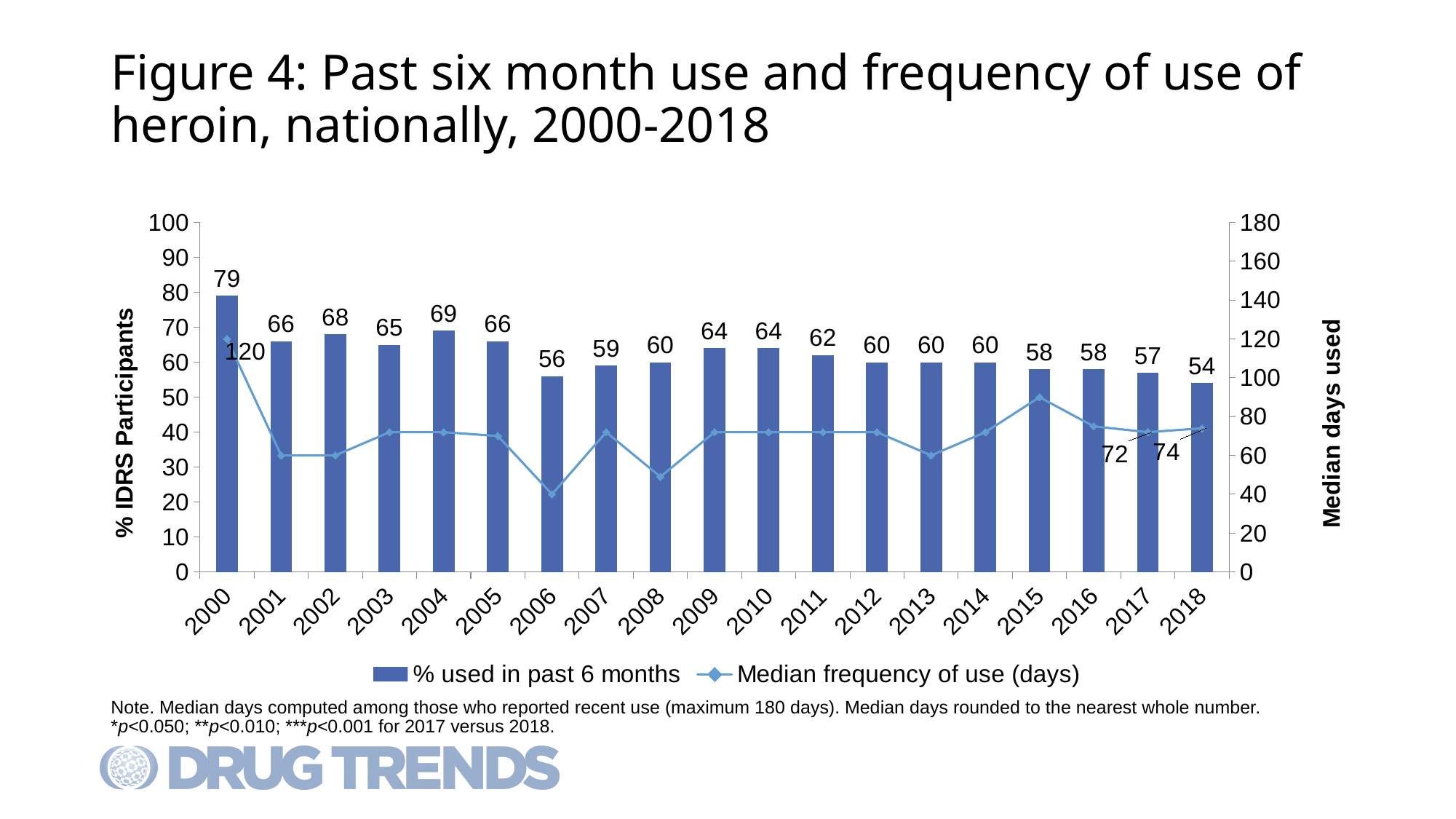
What is the difference in median frequency of use (days) between 2017 and 2018? 2 Is the median frequency of use (days) in 2006 greater or less than 60? less What percentage of IDRS participants reported using heroin in the past 6 months in 2000? 79 Which year had a higher percentage of past six month heroin use, 2004 or 2006? 2004 What percentage of IDRS participants reported using heroin in the past 6 months in 2018? 54 What was the median frequency of heroin use (days) in 2018? 74 By how many percentage points did past six month heroin use fall between 2000 and 2018? 25 What was the median frequency of heroin use (days) in 2000? 120 In which year was the percentage who used heroin in the past 6 months lowest? 2018 In which year was the percentage who used heroin in the past 6 months highest? 2000 How many series does the legend list? 2 How many years are shown on the x axis of the chart? 19